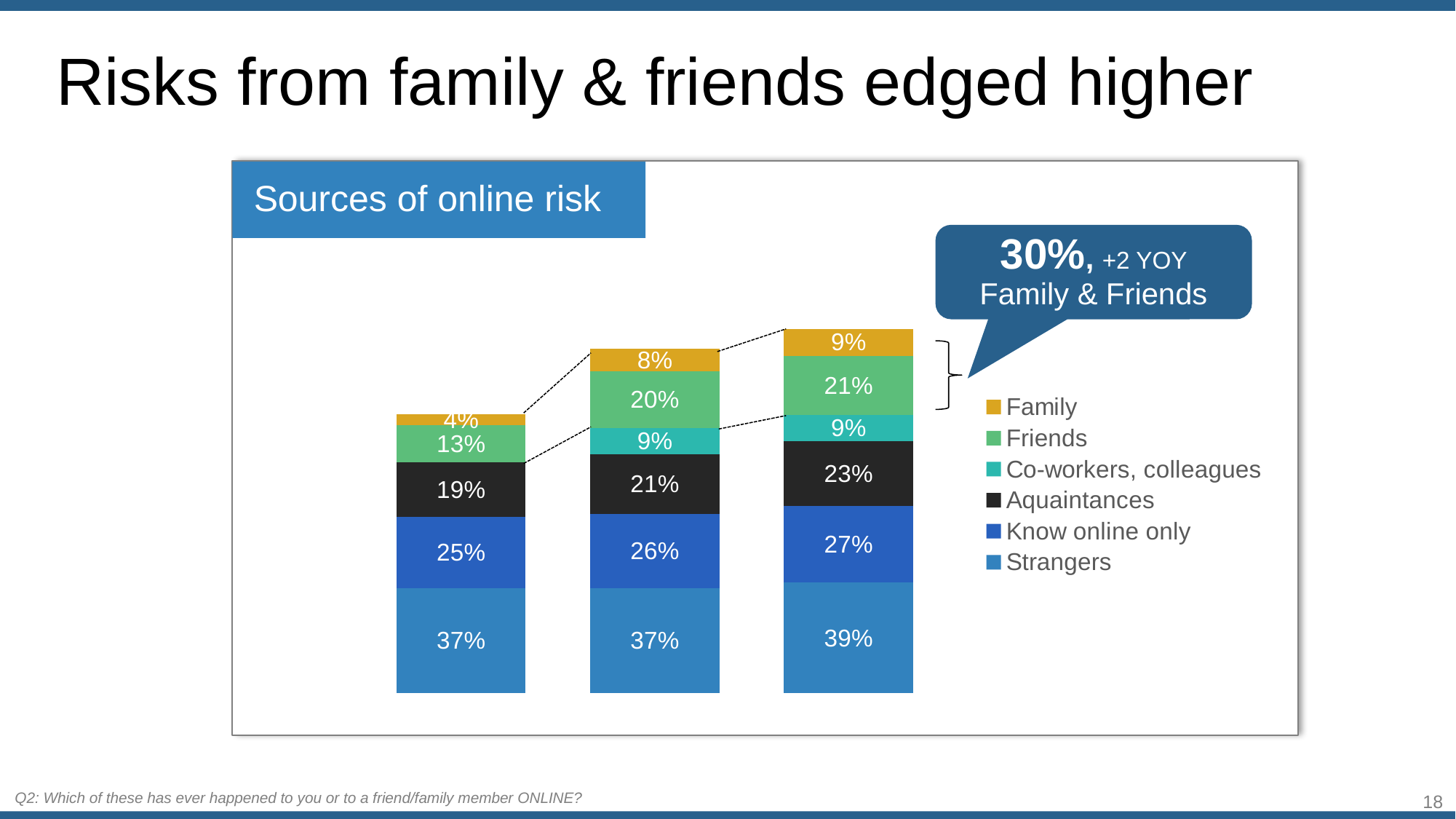
Which segment is the smallest in the middle bar? Family What is the value for Family in the leftmost bar? 4% What type of chart is shown on the slide? Stacked bar chart What is the difference between the Know online only values in the rightmost and leftmost bars? 2% Which segment is the largest in the leftmost bar? Strangers What is the value for Friends in the middle bar? 20% How many stacked bars are plotted in the chart? 3 What is the value for Aquaintances in the rightmost bar? 23% How many series does the legend list? 6 Does the Family value rise or fall from the leftmost bar to the rightmost bar? Rise What is the value for Strangers in the rightmost bar? 39% What is the title of the chart? Sources of online risk